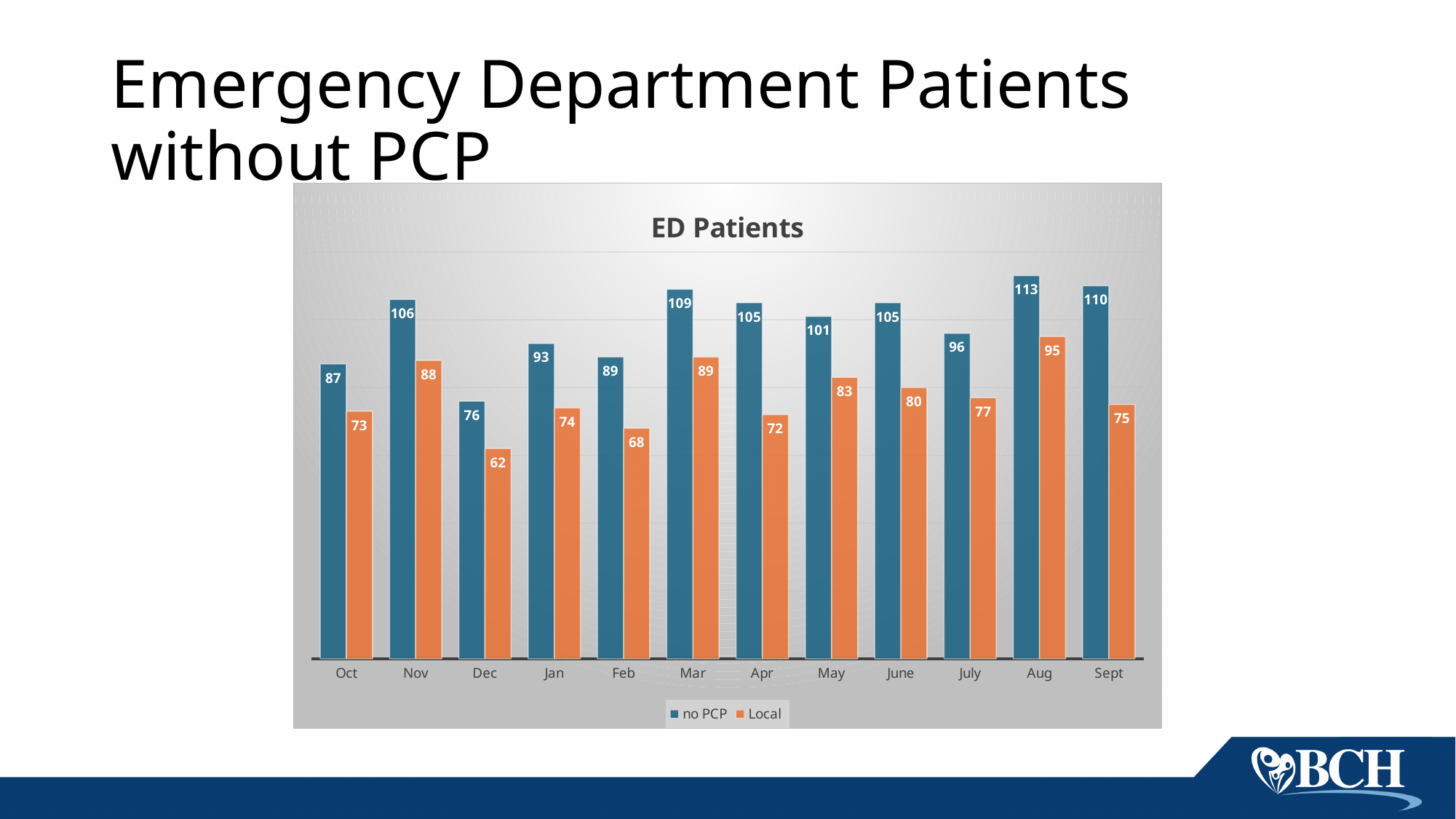
What is the value for no PCP in Mar? 109 What is the value for Local in Dec? 62 What is the value for Local in Aug? 95 How many series does the legend list? 2 Which colour represents the Local series? Orange Which is larger, the Local value in Nov or the Local value in Mar? Mar What is the difference between the no PCP and Local values in Sept? 35 Which month has the highest no PCP value? Aug What kind of chart is shown? Bar chart How many months are shown on the x axis? 12 What is the title of the chart? ED Patients Which month has the lowest Local value? Dec